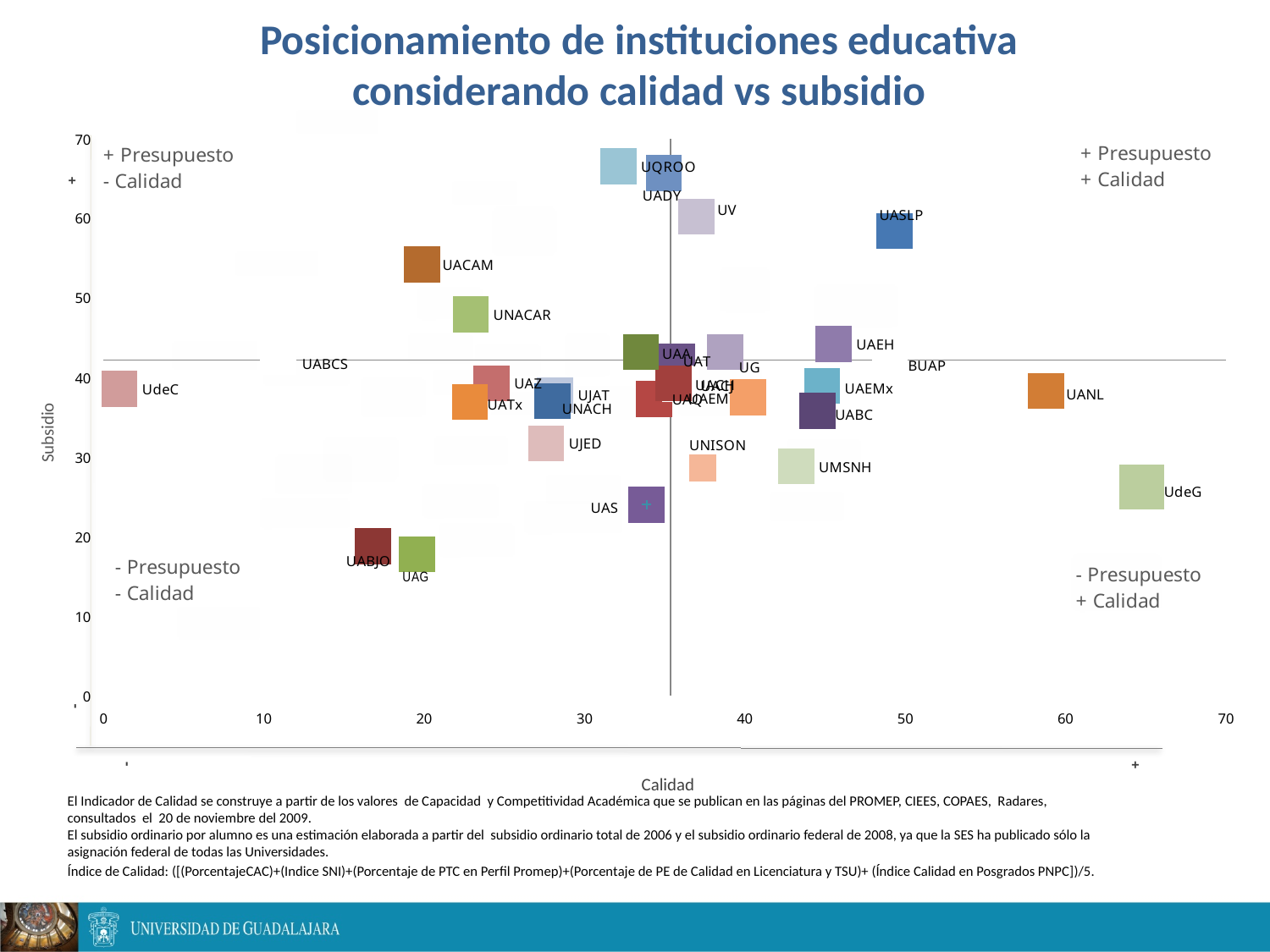
What kind of chart is shown on the slide? Scatter chart Which has the higher Calidad value, UdeG or UANL? UdeG Is the Calidad value for UANL greater or less than 50? greater What are the labels of the x axis and the y axis of the chart? Calidad (x axis) and Subsidio (y axis) What is the title of the chart? Posicionamiento de instituciones educativa considerando calidad vs subsidio Is the Subsidio value for UASLP greater or less than 50? greater Which institution has the lowest Calidad value on the chart? UdeC Which has the higher Subsidio value, UACAM or UNACAR? UACAM Is the Subsidio value for UAS greater or less than 30? less Which institution has the highest Calidad value on the chart? UdeG Which institution has the highest Subsidio value on the chart? UQROO